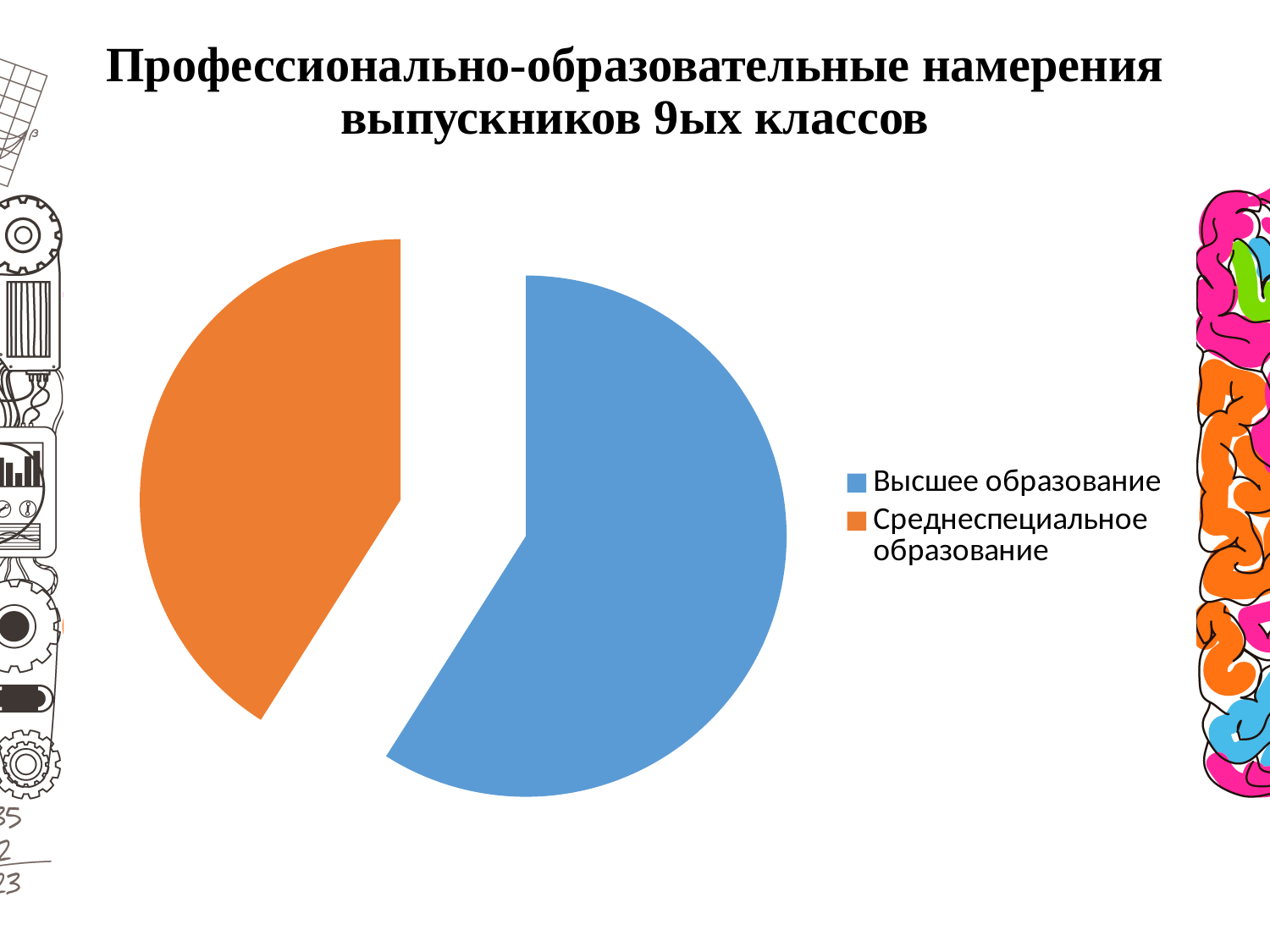
How many entries does the legend list? 2 How many slices does the pie chart have? 2 What is the title of the chart on the slide? Профессионально-образовательные намерения выпускников 9ых классов Which category has the smallest slice of the pie? Среднеспециальное образование Which slice is larger: Высшее образование or Среднеспециальное образование? Высшее образование What kind of chart is shown on the slide? Pie chart Which category has the largest slice of the pie? Высшее образование What colour is the slice for Среднеспециальное образование? Orange